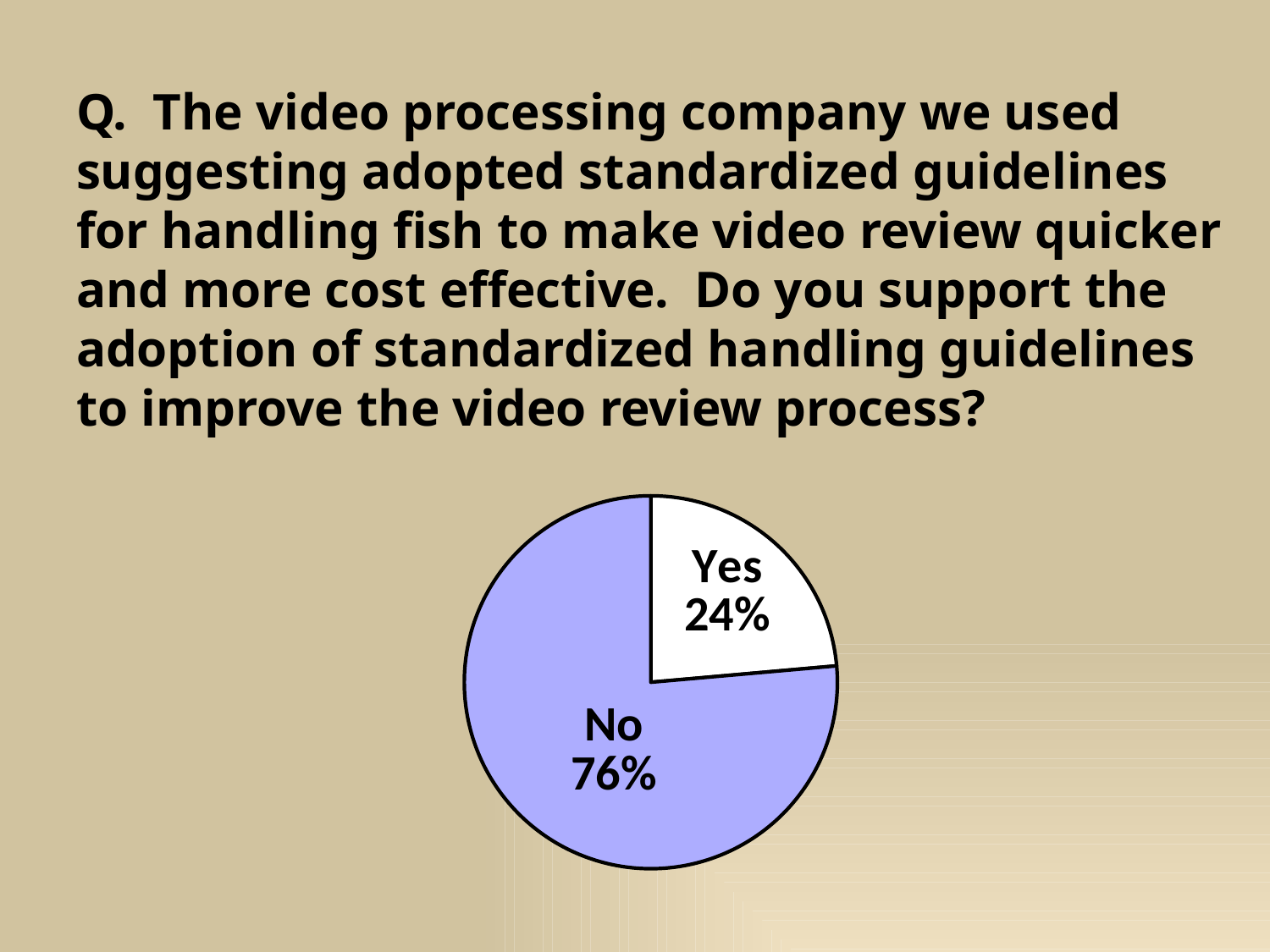
Which slice of the pie is the smallest? Yes What share of the pie does the "No" slice represent? 76% What colour is the "Yes" slice of the pie? white Which slice of the pie is the largest? No How many slices does the pie chart have? 2 What is the combined percentage of the "Yes" and "No" slices? 100% What colour is the "No" slice of the pie? light purple What share of the pie does the "Yes" slice represent? 24% Which is larger, the "Yes" slice or the "No" slice? No What is the difference in percentage points between the "No" and "Yes" slices? 52 What kind of chart is shown on the slide? pie chart